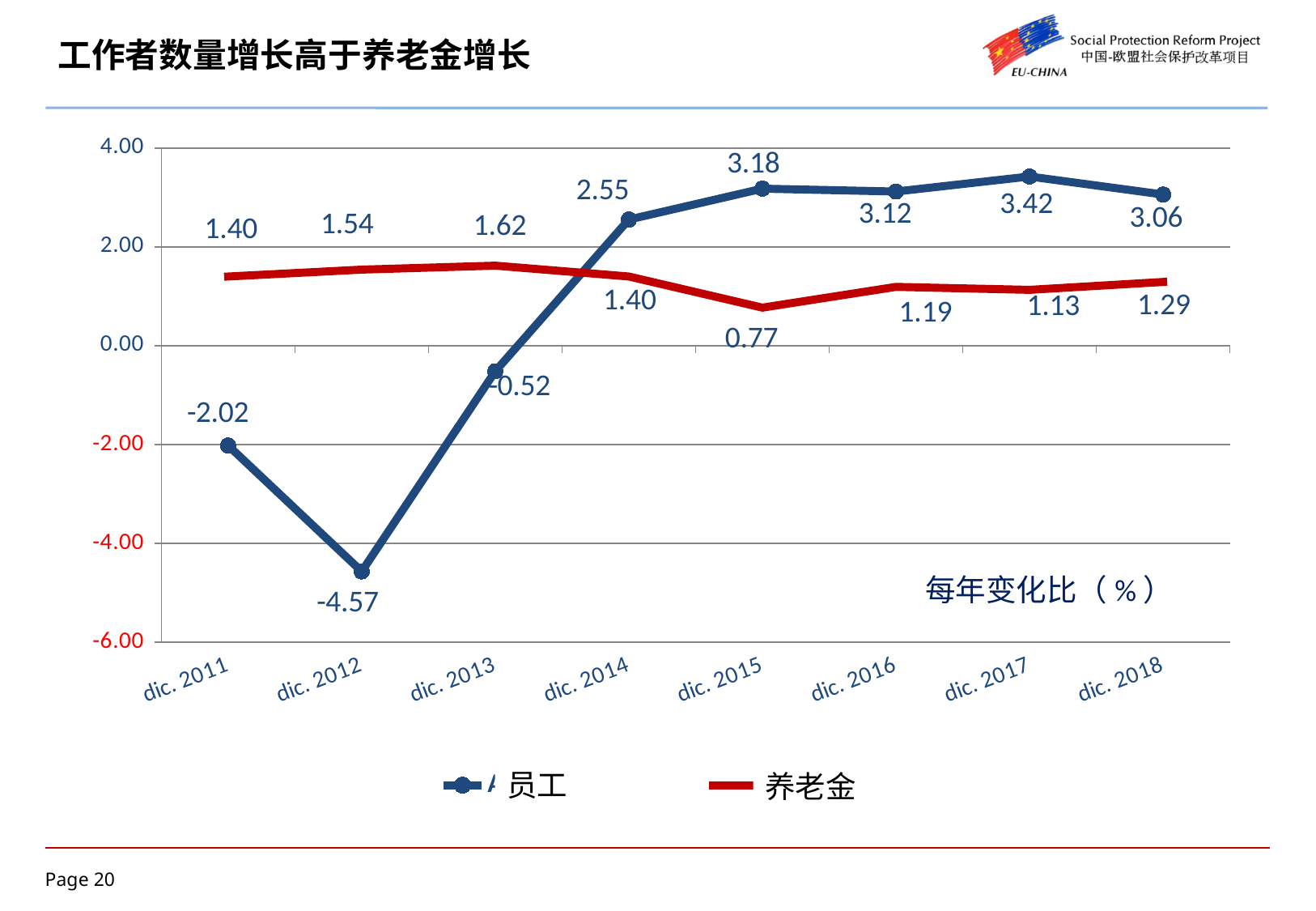
What is the difference between the 员工 value and the 养老金 value at dic. 2018? 1.77 At which date does the 员工 series reach its highest value? dic. 2017 How many series does the legend list? 2 What kind of chart is shown on the slide? Line chart Which series has the larger value at dic. 2013, 员工 or 养老金? 养老金 At which date does the 员工 series reach its lowest value? dic. 2012 At which date does the 养老金 series reach its lowest value? dic. 2015 What is the value for 养老金 at dic. 2015? 0.77 What is the value for 员工 at dic. 2017? 3.42 What is the value for 员工 at dic. 2012? -4.57 What is the value for 养老金 at dic. 2013? 1.62 How many dates are shown on the x axis? 8